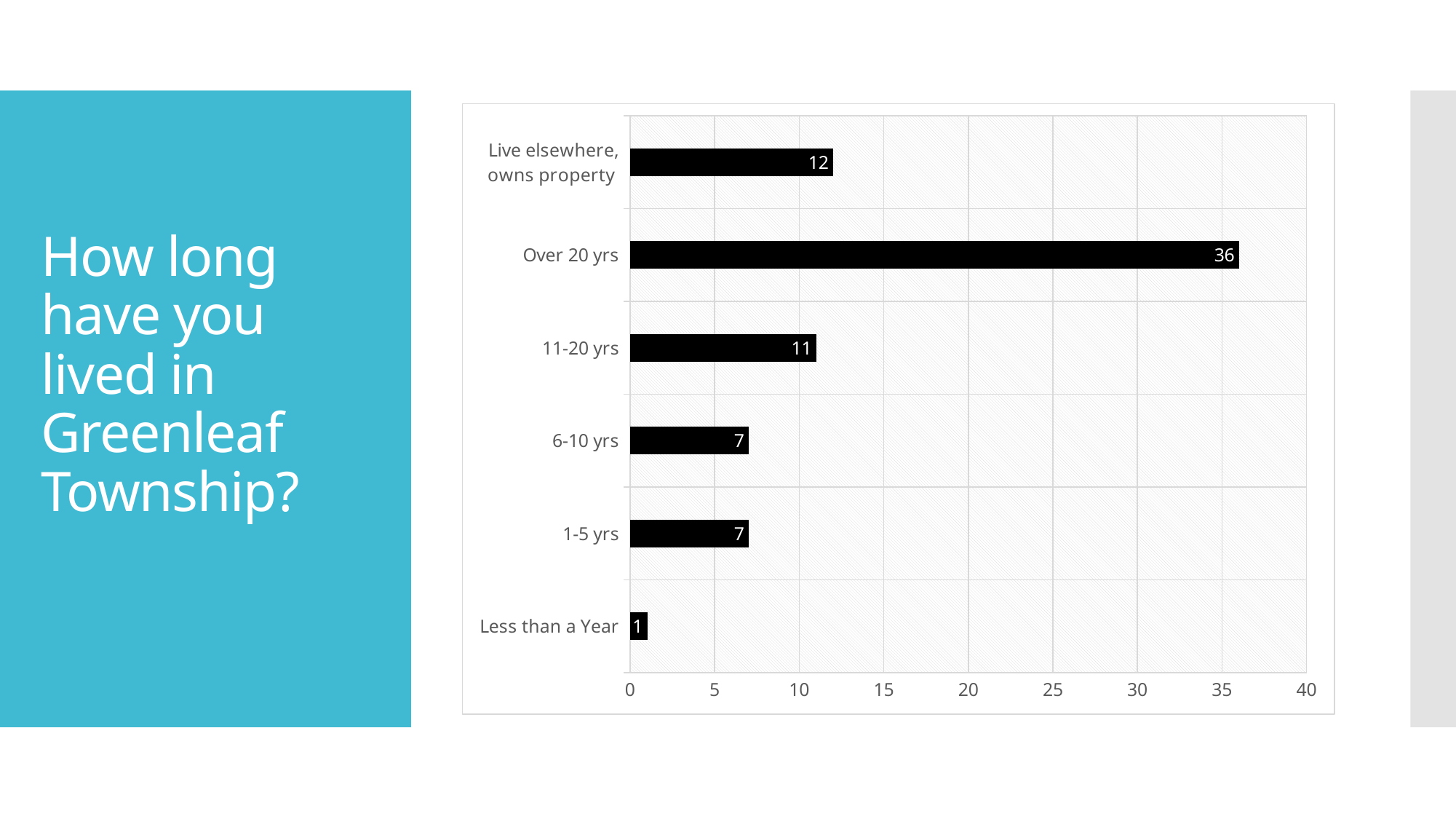
What is the difference between the values for '11-20 yrs' and '6-10 yrs'? 4 What is the maximum value shown on the horizontal axis? 40 What kind of chart is shown on the slide? Bar chart Which is larger, the value for 'Live elsewhere, owns property' or the value for '11-20 yrs'? Live elsewhere, owns property How many categories are shown in the chart? 6 What is the value for 'Over 20 yrs'? 36 Which category has the highest value? Over 20 yrs What is the difference between the values for 'Over 20 yrs' and 'Live elsewhere, owns property'? 24 What is the value for 'Live elsewhere, owns property'? 12 What is the value for '11-20 yrs'? 11 Which category has the lowest value? Less than a Year What is the value for 'Less than a Year'? 1